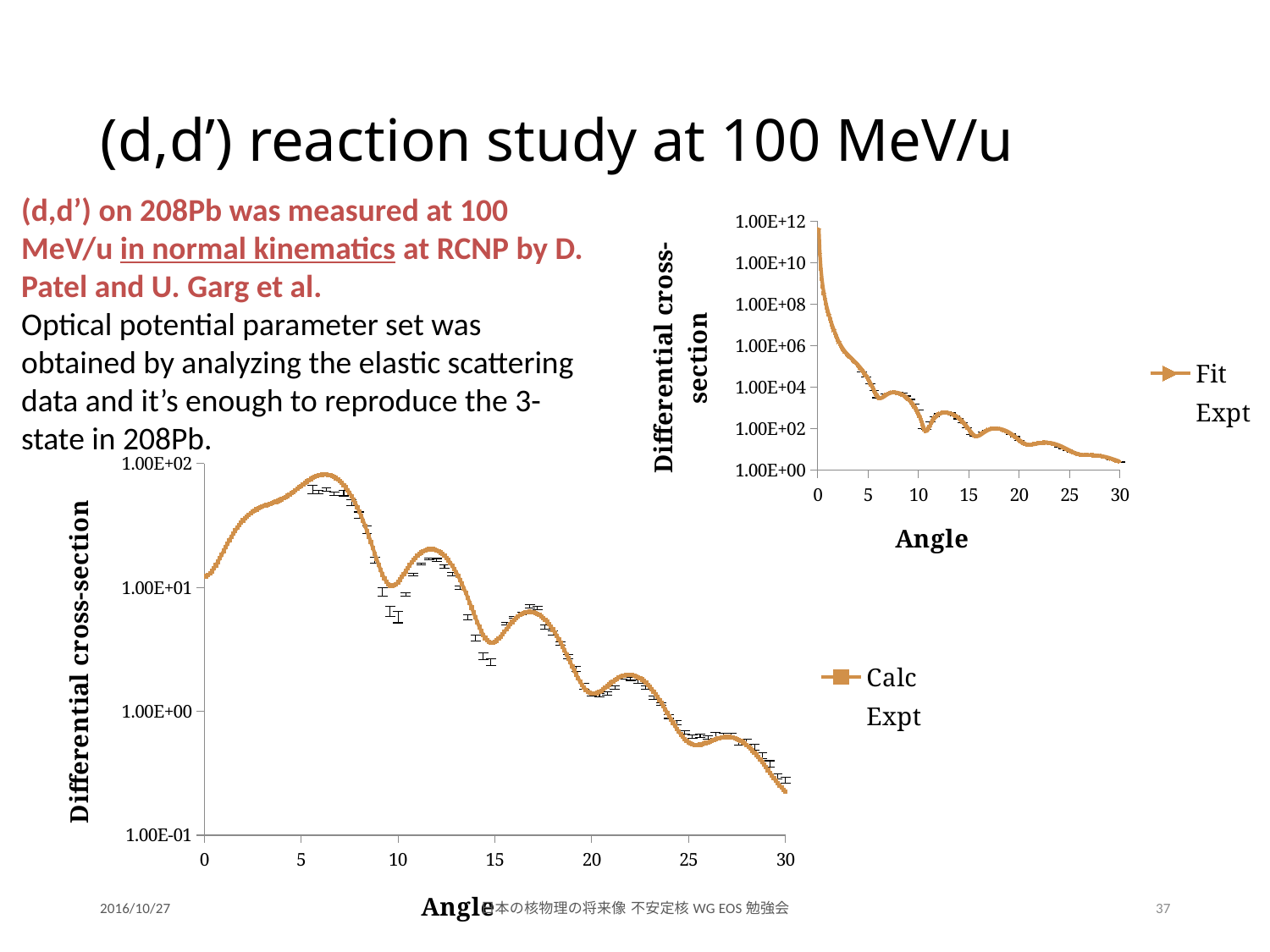
How many series does the legend of the top-right chart list? 2 In the top-right chart, is the Fit value at angle 30 greater or less than 1.00E+02? less What kind of chart is the top-right chart on the slide? line chart In the bottom-left chart, is the Calc value at angle 0 greater or less than 1.00E+01? greater In the top-right chart, do the Fit values overall rise or fall as the angle increases from 0 to 30? fall What are the two legend entries of the top-right chart? Fit and Expt How many series does the legend of the bottom-left chart list? 2 What are the two legend entries of the bottom-left chart? Calc and Expt In the top-right chart, is the Fit value at angle 0 greater or less than 1.00E+10? greater What kind of chart is the bottom-left chart on the slide? line chart In the bottom-left chart, do the Calc values overall rise or fall as the angle increases from 0 to 30? fall